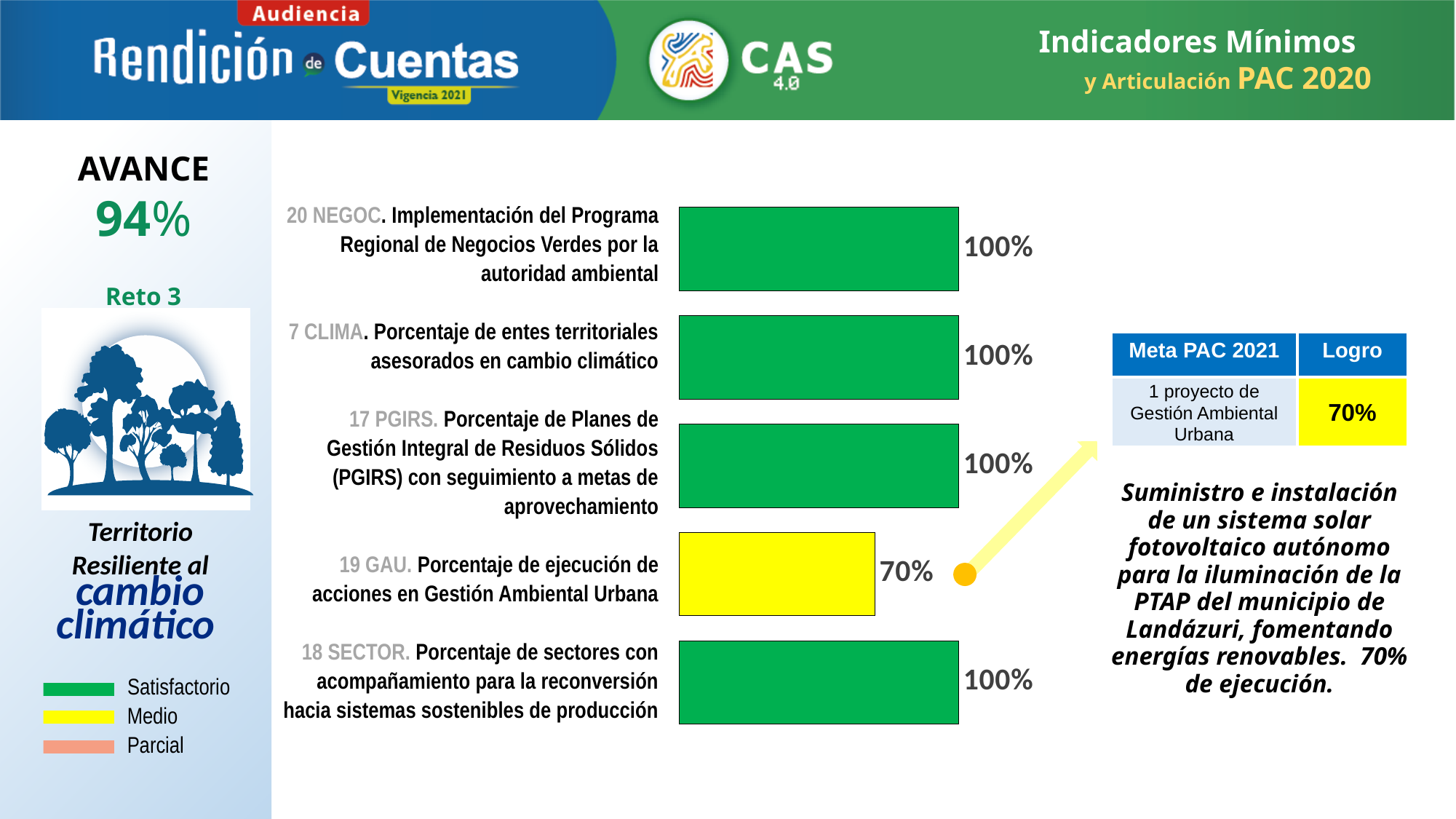
What is the value shown for the bar labelled 17 PGIRS? 100% Which is larger, the value for 18 SECTOR or the value for 19 GAU? 18 SECTOR What is the value shown for the bar labelled 19 GAU? 70% How many categories does the colour legend list? 3 How many bars are shown in the chart? 5 Which indicator has the lowest value in the bar chart? 19 GAU How many bars in the chart have a value of 100%? 4 What is the difference between the value for 7 CLIMA and the value for 19 GAU? 30% What kind of chart is shown on the slide? Bar chart What colour is the bar for 19 GAU? Yellow What is the value shown for the bar labelled 20 NEGOC? 100% According to the legend, what does the yellow colour represent? Medio